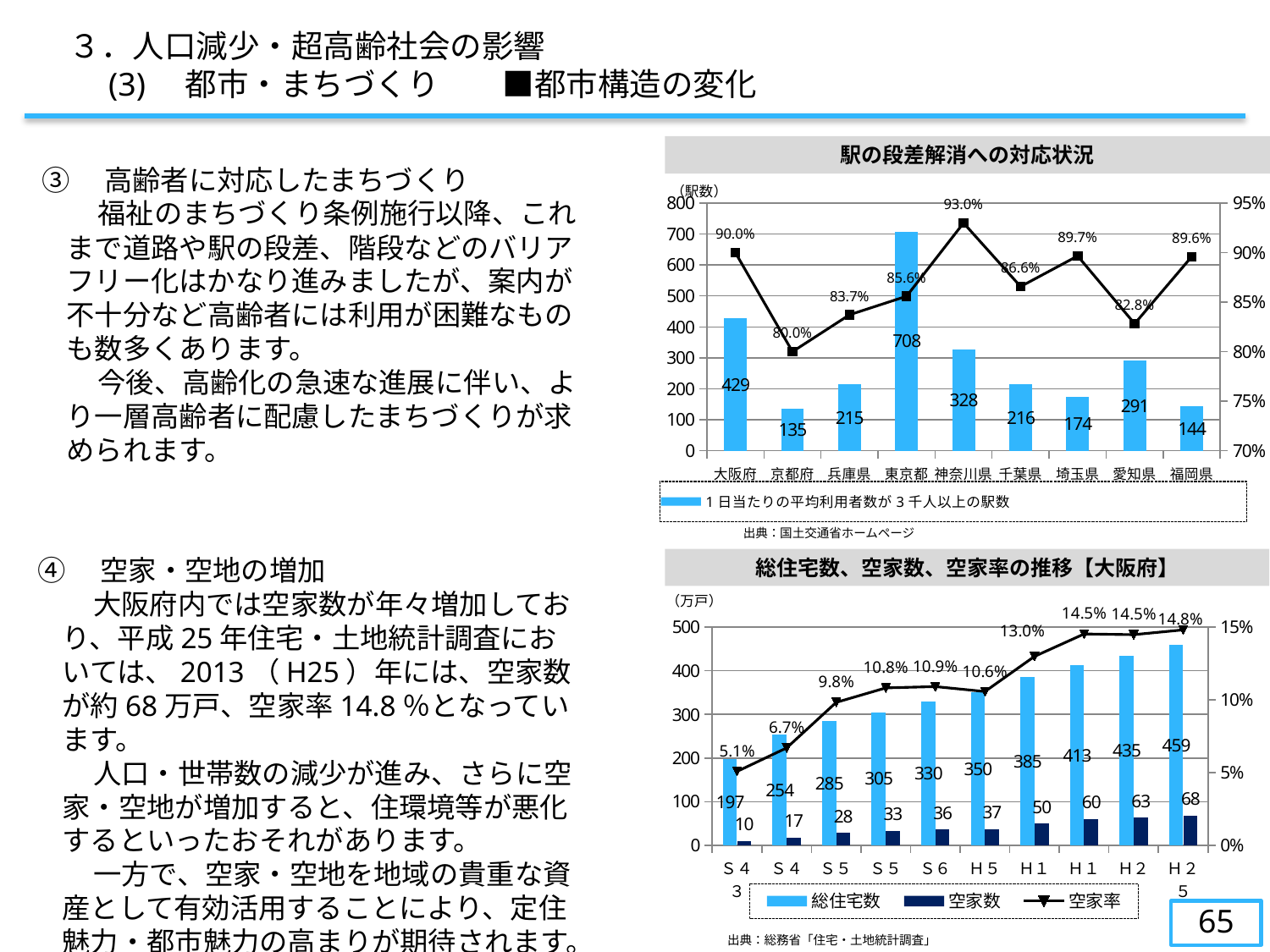
In the chart titled 駅の段差解消への対応状況, which is larger, the bar value for 神奈川県 or 愛知県? 神奈川県 In the chart titled 駅の段差解消への対応状況, what is the bar value for 東京都? 708 In the chart titled 駅の段差解消への対応状況, what is the bar value for 大阪府? 429 In the chart titled 駅の段差解消への対応状況, which prefecture has the lowest bar value? 京都府 In the chart titled 総住宅数、空家数、空家率の推移【大阪府】, what is the highest 総住宅数 value shown? 459 In the chart titled 総住宅数、空家数、空家率の推移【大阪府】, how many series does the legend list? 3 In the chart titled 総住宅数、空家数、空家率の推移【大阪府】, what is the difference between the highest and lowest 空家数 values? 58 In the chart titled 駅の段差解消への対応状況, what is the difference between the bar values for 東京都 and 大阪府? 279 In the chart titled 総住宅数、空家数、空家率の推移【大阪府】, what is the 空家率 value at the rightmost point? 14.8% In the chart titled 総住宅数、空家数、空家率の推移【大阪府】, does the 総住宅数 series rise or fall from left to right? rise In the chart titled 駅の段差解消への対応状況, what is the line (percentage) value for 神奈川県? 93.0% In the chart titled 駅の段差解消への対応状況, how many prefectures are shown on the x axis? 9